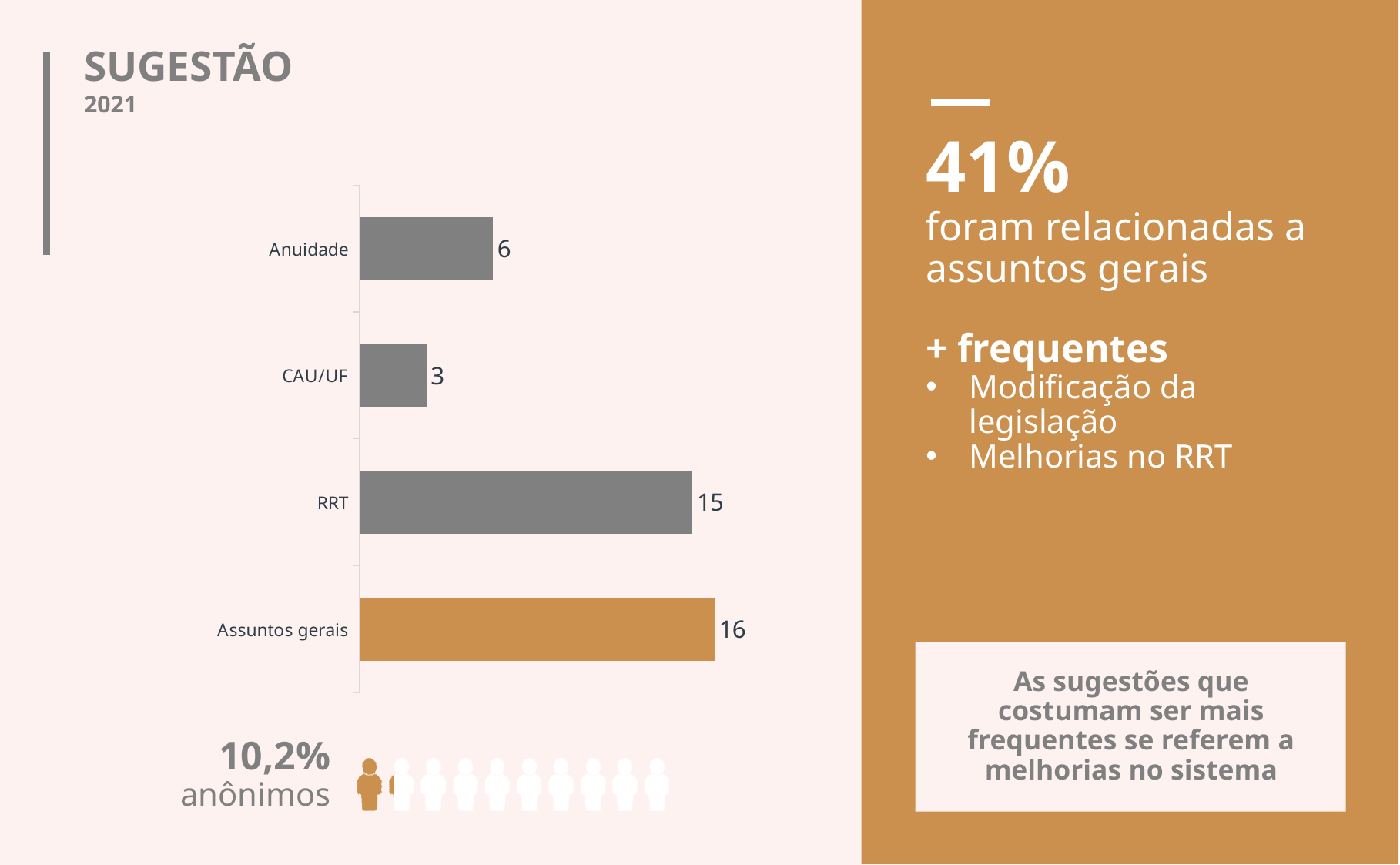
What is the value for CAU/UF? 3 What is the difference between the values for Assuntos gerais and CAU/UF? 13 What is the value for Assuntos gerais? 16 Which category has the lowest value? CAU/UF What kind of chart is shown on the slide? bar chart What is the value for RRT? 15 What is the value for Anuidade? 6 Which category has the highest value? Assuntos gerais What is the difference between the values for RRT and Anuidade? 9 Which bar in the chart is coloured differently from the others? Assuntos gerais How many categories are shown in the chart? 4 Which is larger, the value for Anuidade or the value for CAU/UF? Anuidade